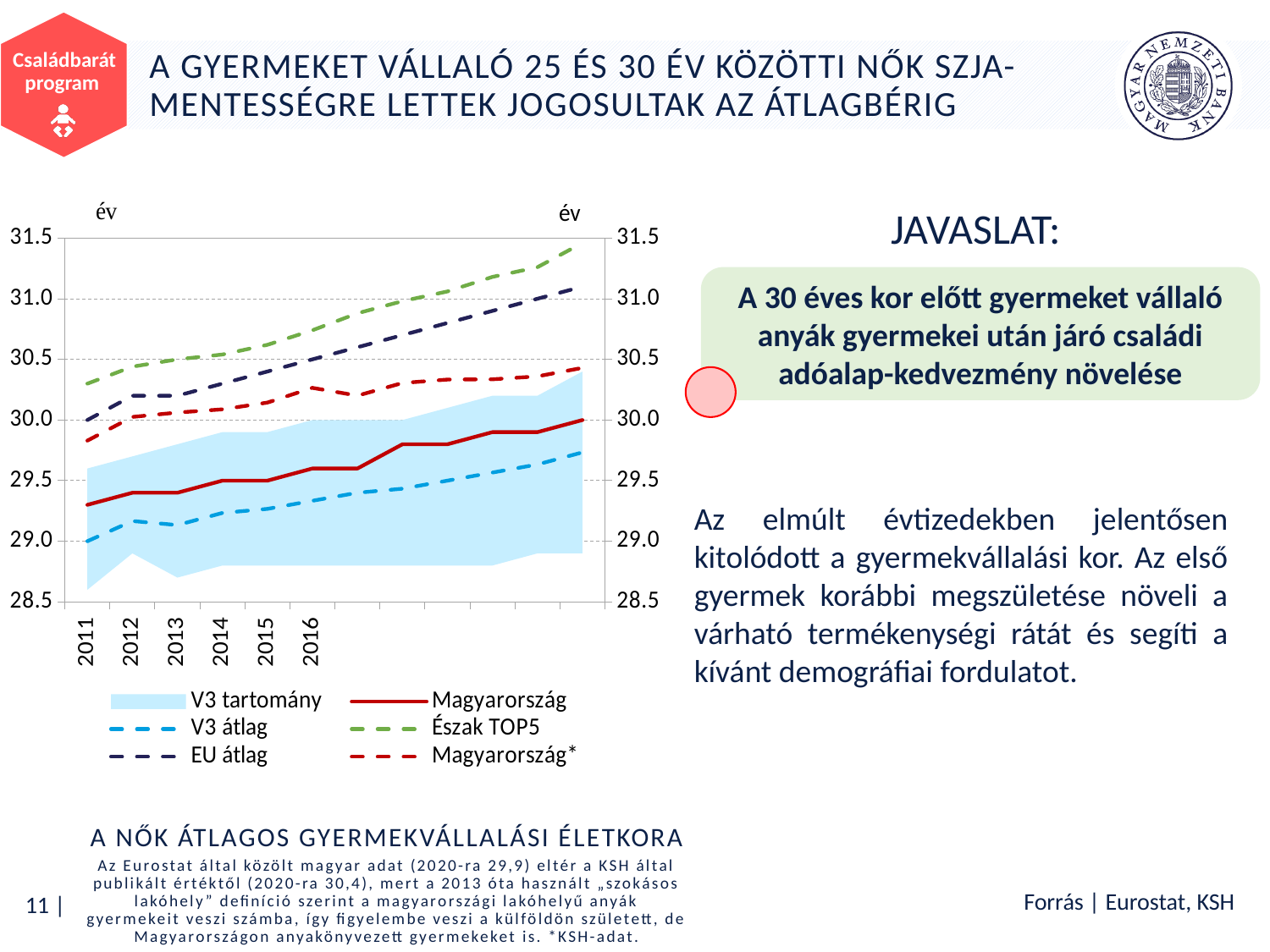
How many series does the chart legend list? 6 Does the Észak TOP5 series rise or fall over the years shown? rise Is the value for Magyarország* in 2011 greater or less than 30.0? less Does the Magyarország series rise or fall over the years shown? rise What unit label is shown at the top of the vertical axes of the chart? év Is the value for Észak TOP5 in 2011 greater or less than 30.0? greater What is the title of the chart? A NŐK ÁTLAGOS GYERMEKVÁLLALÁSI ÉLETKORA What kind of chart is shown on the slide? combination area and line chart Which series has the lowest value in 2016? V3 átlag Which series has the highest value in 2016? Észak TOP5 In 2013, which is higher: EU átlag or V3 átlag? EU átlag Is the value for Magyarország in 2011 greater or less than 29.5? less